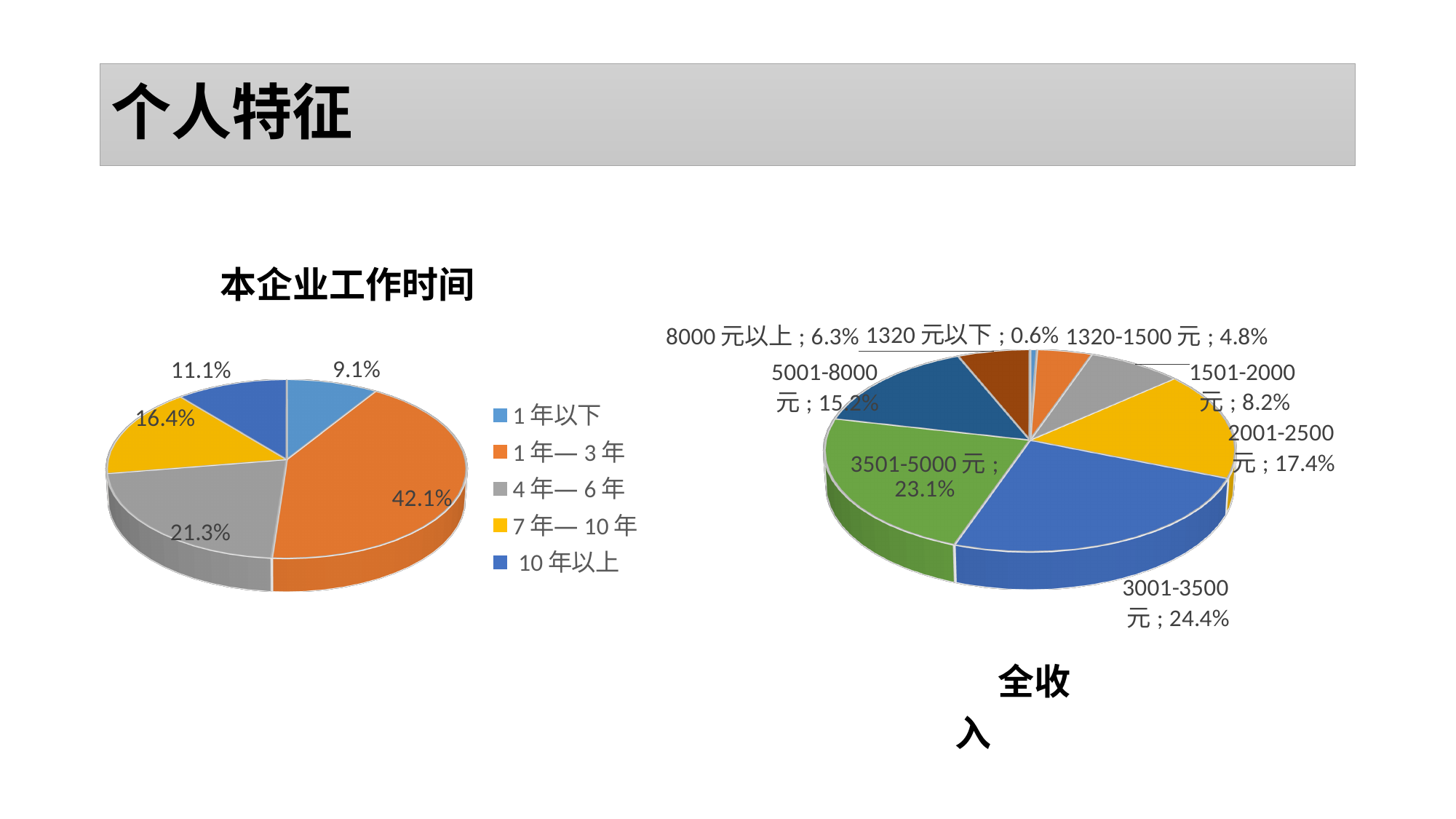
In the left chart 本企业工作时间, what share is labelled for 1年—3年? 42.1% In the right chart 全收入, how many income categories are shown? 8 In the left chart 本企业工作时间, what is the difference between the shares for 4年—6年 and 10年以上? 10.2% In the right chart 全收入, what share is labelled for 3001-3500元? 24.4% In the left chart 本企业工作时间, which category has the largest share? 1年—3年 In the left chart 本企业工作时间, how many categories does the legend list? 5 In the right chart 全收入, which is larger, the share for 2001-2500元 or the share for 3501-5000元? 3501-5000元 In the left chart 本企业工作时间, what share is labelled for 7年—10年? 16.4% In the left chart 本企业工作时间, which category has the smallest share? 1年以下 In the right chart 全收入, what share is labelled for 5001-8000元? 15.2% In the right chart 全收入, which income category has the smallest share? 1320元以下 What type of chart is the left chart titled 本企业工作时间? pie chart